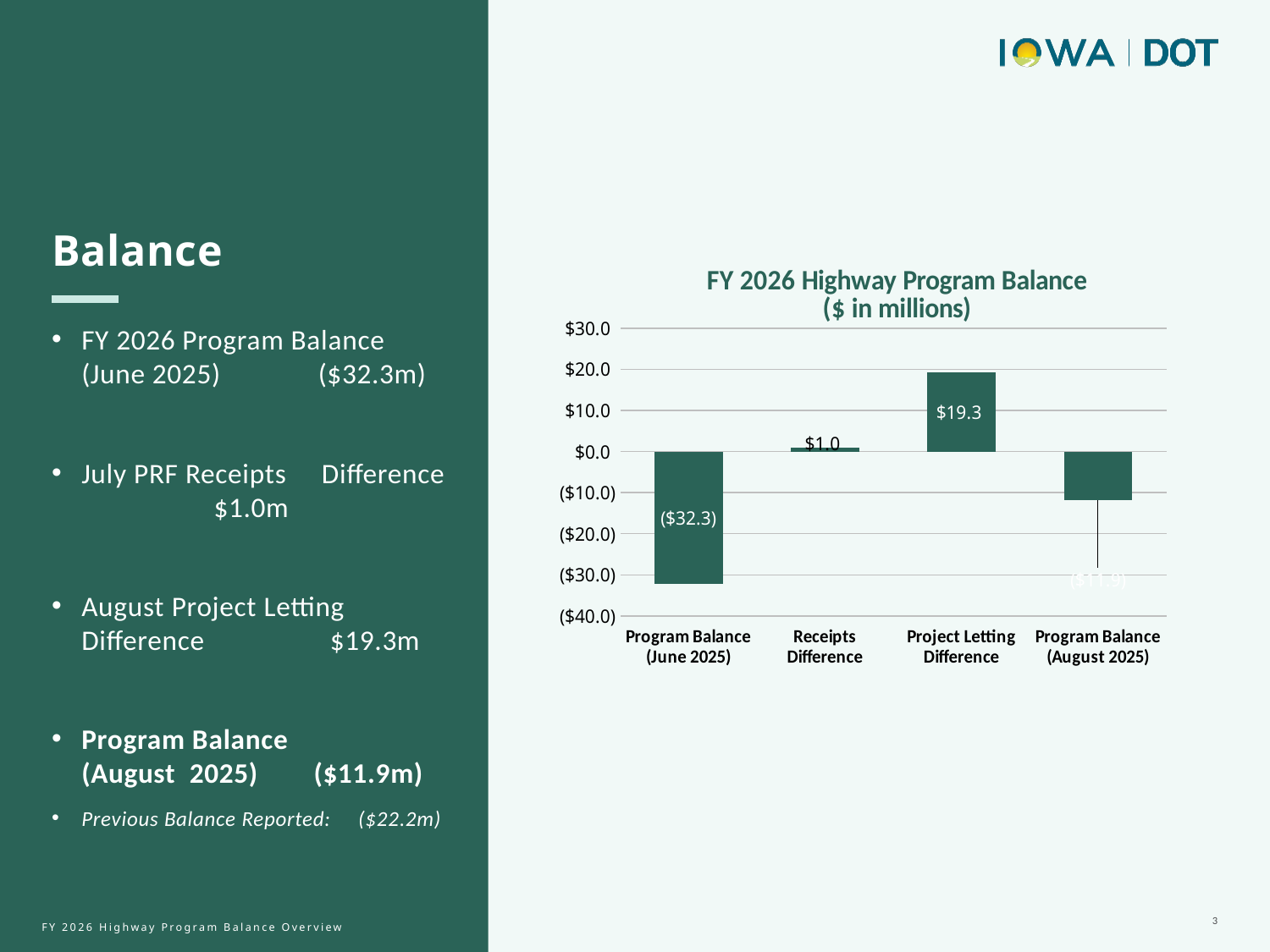
Which category has the highest value in the chart? Project Letting Difference How many categories are shown on the x axis of the chart? 4 What is the value for Program Balance (June 2025) in the FY 2026 Highway Program Balance chart? ($32.3) What is the value for Program Balance (August 2025) in the chart? ($11.9) Which is larger, the value for Project Letting Difference or the value for Receipts Difference? Project Letting Difference What is the difference between the Project Letting Difference and the Receipts Difference values? $18.3 What is the title of the chart? FY 2026 Highway Program Balance ($ in millions) Which category has the lowest value in the chart? Program Balance (June 2025) Is the value for Program Balance (June 2025) greater or less than ($30.0)? less What kind of chart is shown on the slide? bar chart What is the value for Receipts Difference in the chart? $1.0 What is the value for Project Letting Difference in the chart? $19.3